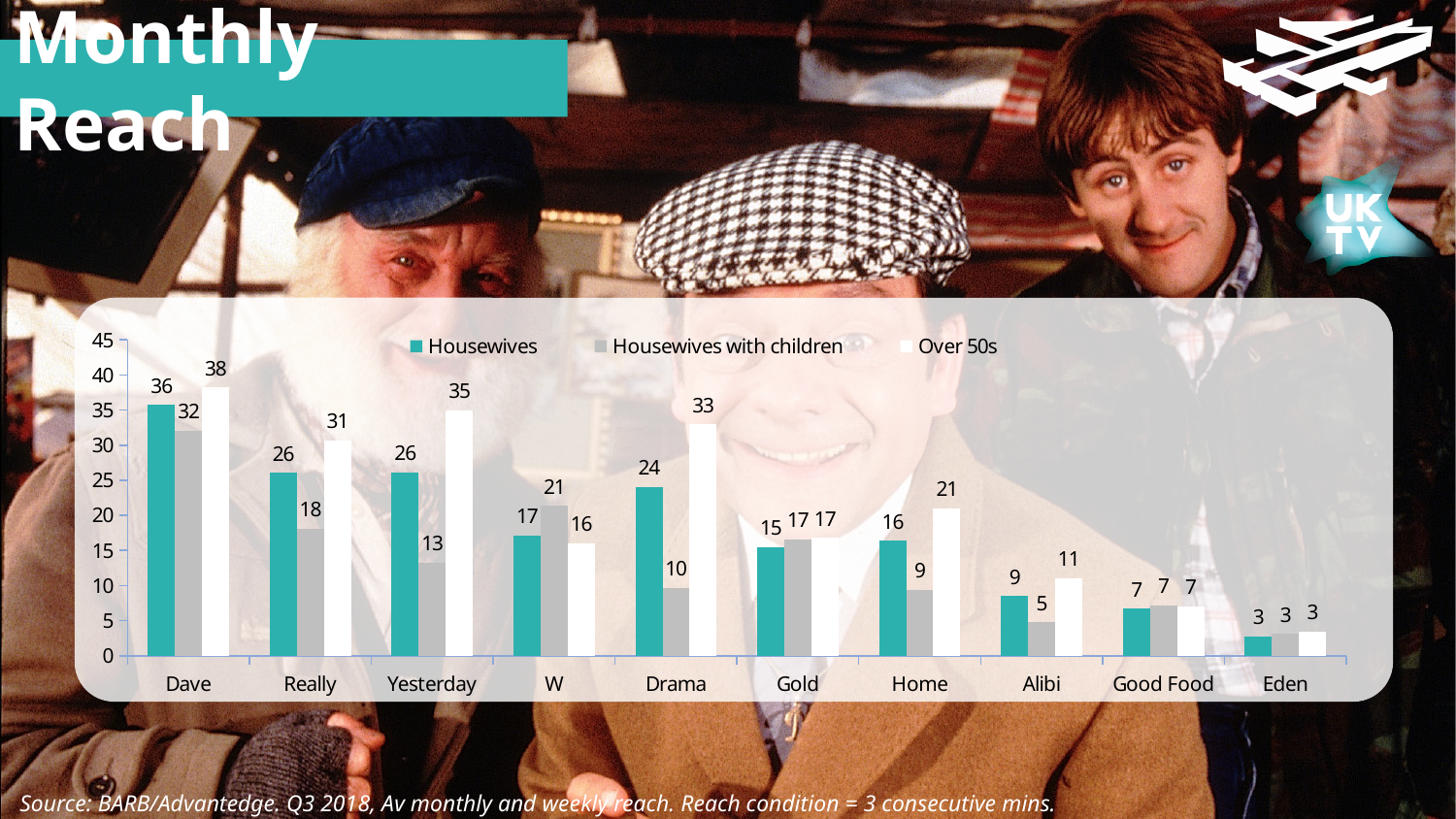
Do the Housewives values generally rise or fall from Dave to Eden? Fall How many series does the legend list? 3 What is the difference between the Over 50s and Housewives with children values for Yesterday? 22 What is the Over 50s value for Drama? 33 What is the Housewives with children value for Yesterday? 13 Which channel has the highest Over 50s value? Dave What is the title of the slide? Monthly Reach What is the Housewives value for Dave? 36 Which channel has the lowest Housewives value? Eden How many channels are shown on the x axis? 10 For W, which is larger: the Housewives value or the Housewives with children value? Housewives with children What kind of chart is shown on the slide? Bar chart